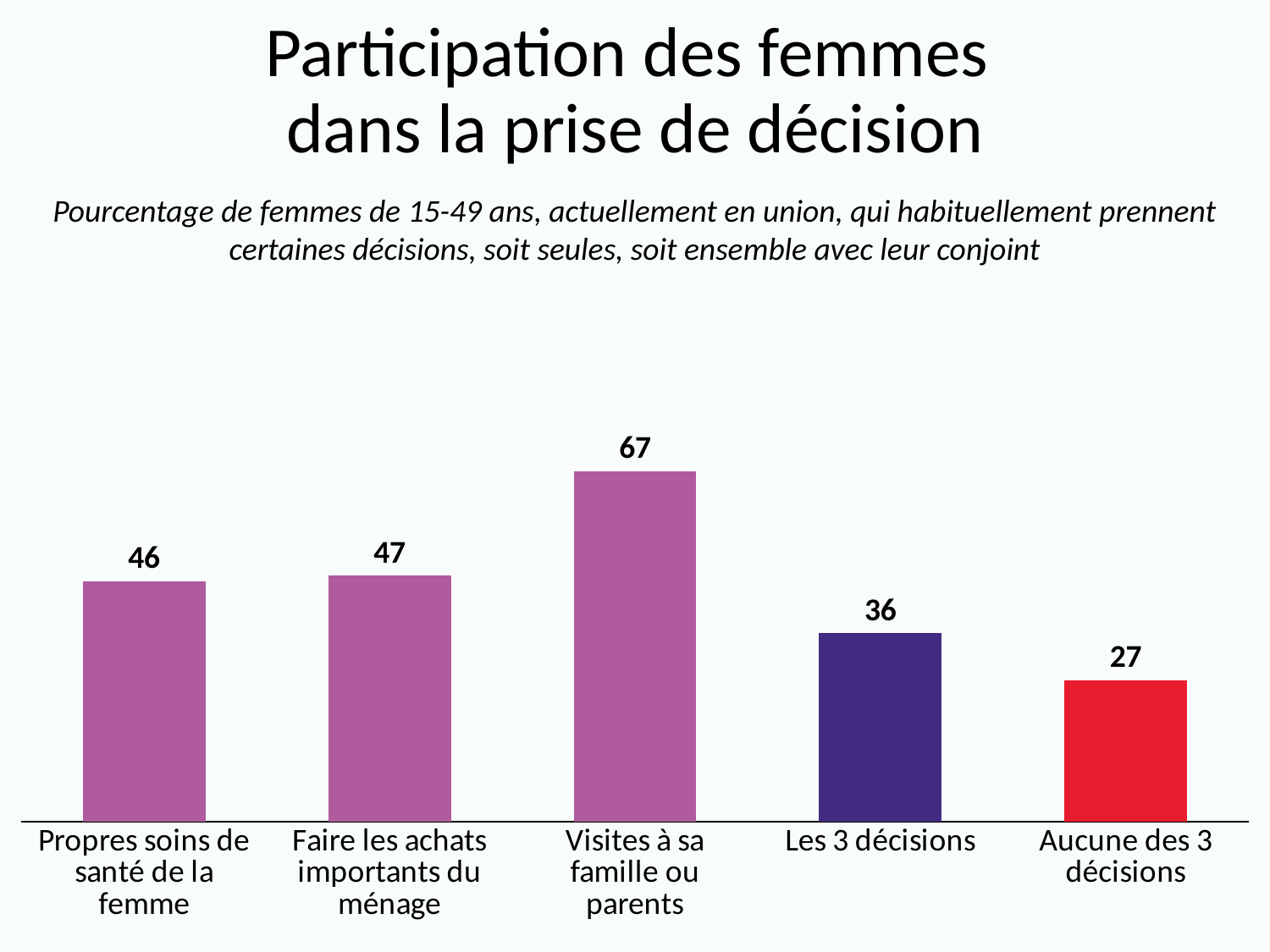
How many categories are shown in the chart? 5 What kind of chart is shown on the slide? Bar chart What is the difference between the values for "Visites à sa famille ou parents" and "Les 3 décisions"? 31 What is the value for "Aucune des 3 décisions"? 27 What is the value for "Propres soins de santé de la femme"? 46 What colour is the bar for "Aucune des 3 décisions"? Red Which category has the highest value? Visites à sa famille ou parents Which is larger: the value for "Les 3 décisions" or the value for "Aucune des 3 décisions"? Les 3 décisions What is the difference between the values for "Faire les achats importants du ménage" and "Aucune des 3 décisions"? 20 Which category has the lowest value? Aucune des 3 décisions What is the value for "Les 3 décisions"? 36 What is the value for "Visites à sa famille ou parents"? 67